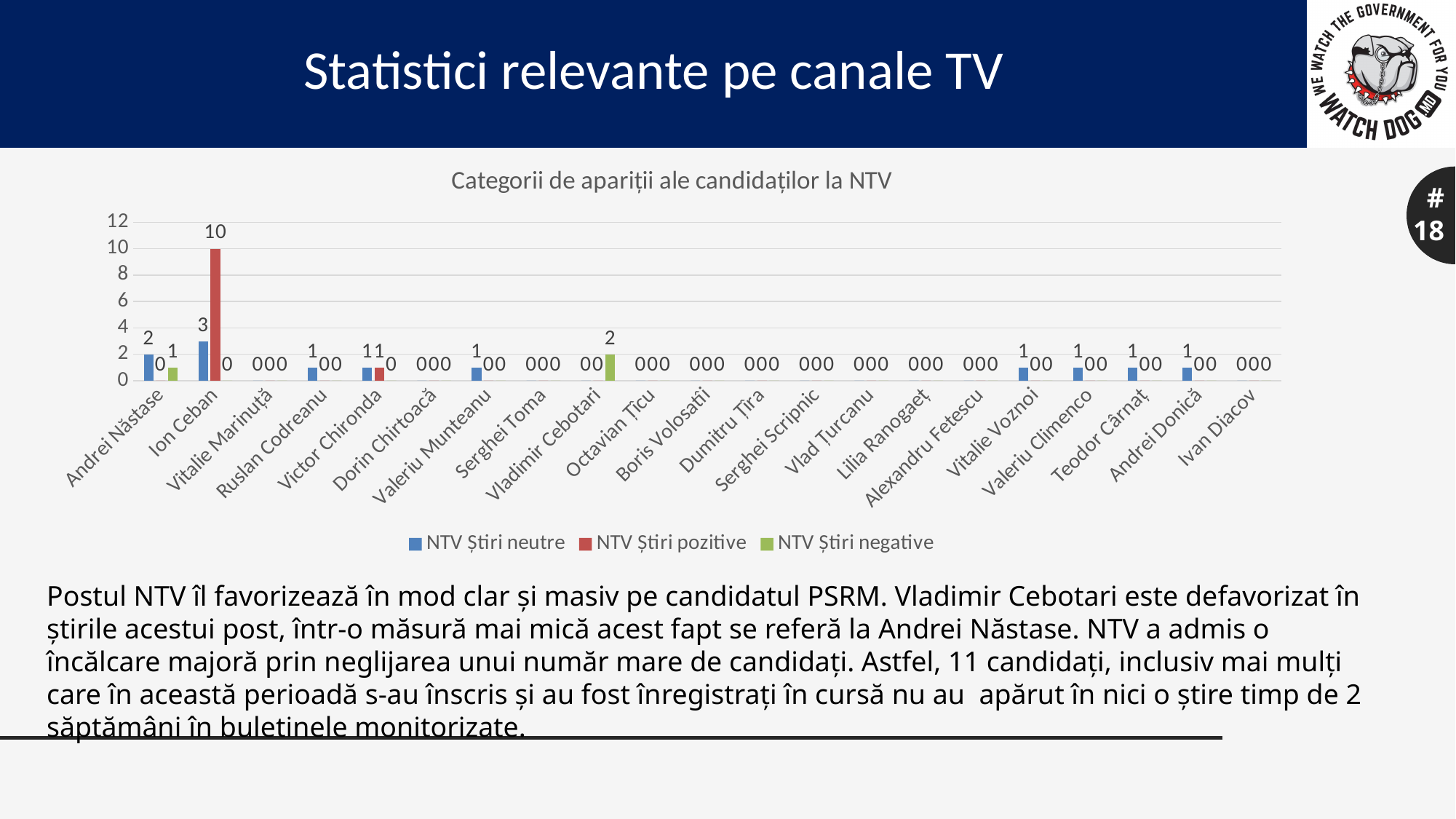
Which candidate has the highest value for NTV Știri pozitive? Ion Ceban What is the value of NTV Știri neutre for Andrei Năstase? 2 What is the difference between NTV Știri pozitive and NTV Știri neutre for Ion Ceban? 7 What is the value of NTV Știri negative for Vladimir Cebotari? 2 Which candidate has the highest value for NTV Știri neutre? Ion Ceban Which is larger for Andrei Năstase: NTV Știri neutre or NTV Știri negative? NTV Știri neutre What is the value of NTV Știri neutre for Ion Ceban? 3 What is the total of the three series for Ion Ceban? 13 What type of chart is shown on the slide? Bar chart What is the value of NTV Știri pozitive for Ion Ceban? 10 How many series does the legend list? 3 How many candidates are shown on the x axis? 21